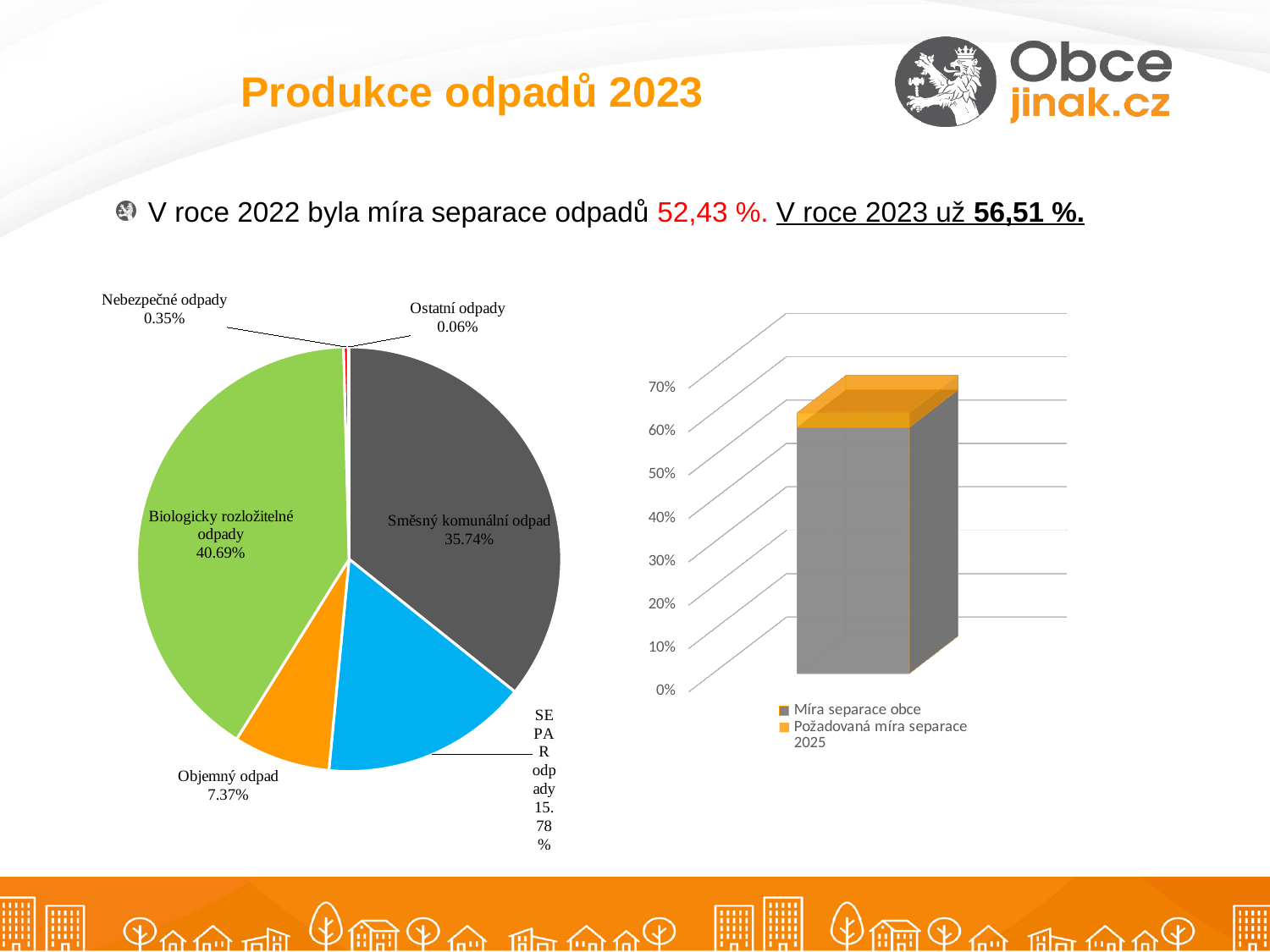
What kind of chart is shown on the left of the slide? Pie chart In the pie chart on the left, which category has the smallest share? Ostatní odpady In the pie chart on the left, what is the value for Objemný odpad? 7.37% In the bar chart on the right, is the value for Míra separace obce greater or less than 50%? greater How many slices does the pie chart on the left have? 6 In the pie chart on the left, what is the difference between Biologicky rozložitelné odpady and Směsný komunální odpad? 4.95% In the pie chart on the left, which category has the largest share? Biologicky rozložitelné odpady In the pie chart on the left, which is larger: SEPAR odpady or Objemný odpad? SEPAR odpady In the pie chart on the left, what is the value for Směsný komunální odpad? 35.74% In the pie chart on the left, what is the value for Nebezpečné odpady? 0.35% In the pie chart on the left, what share does Biologicky rozložitelné odpady have? 40.69% How many series does the legend of the bar chart on the right list? 2